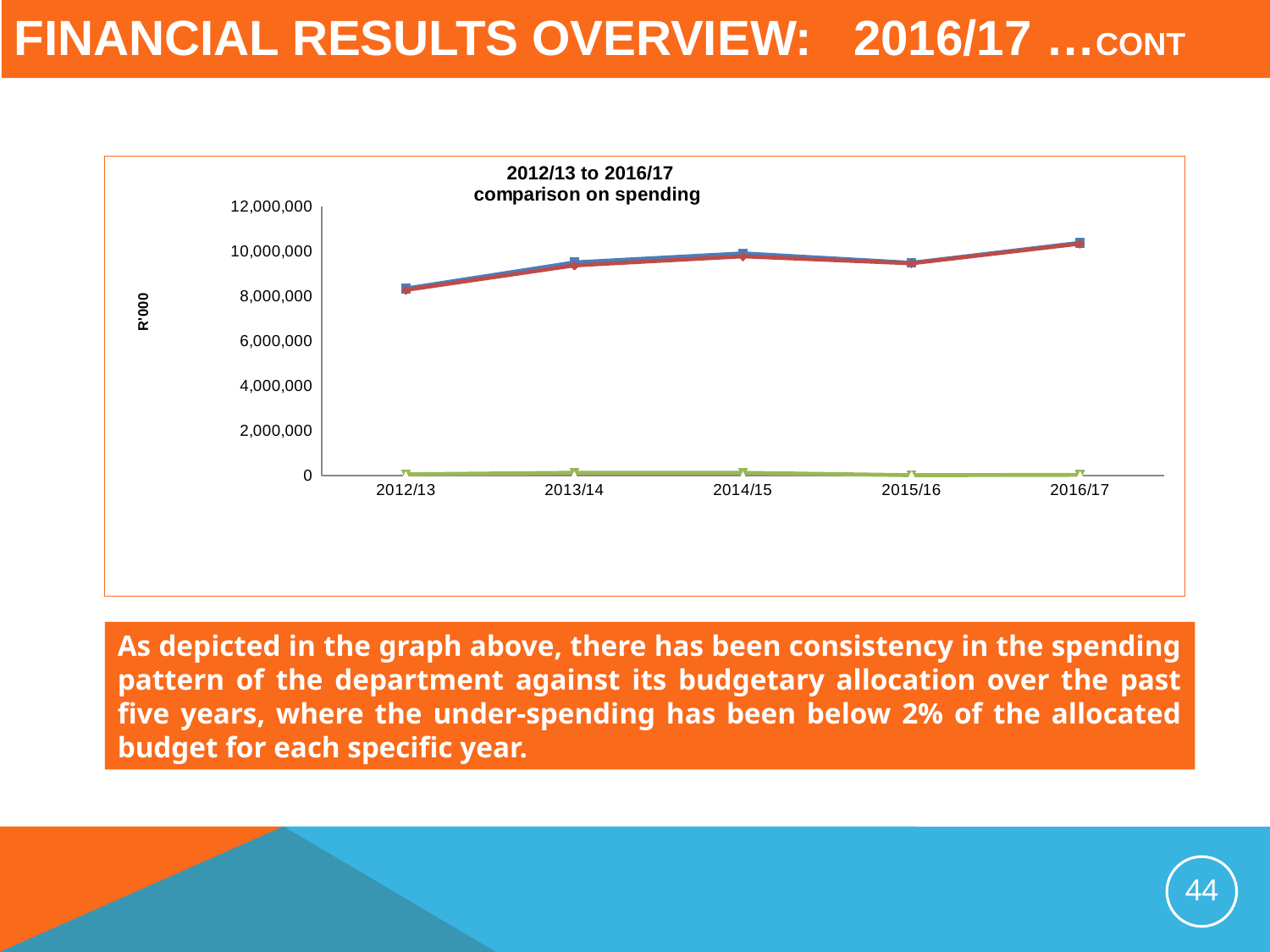
What is the label on the vertical axis of the chart? R'000 Which financial year is the last point on the x axis? 2016/17 Which financial year is the first point on the x axis? 2012/13 How many financial years are plotted along the x axis? 5 Is the value of the blue line for 2012/13 greater or less than 10,000,000? less Is the value of the blue line for 2016/17 greater or less than 10,000,000? greater Is the value of the green line for 2014/15 greater or less than 2,000,000? less Does the blue line rise or fall from 2012/13 to 2014/15? rise In which financial year does the blue line reach its highest value? 2016/17 In which financial year does the blue line reach its lowest value? 2012/13 What kind of chart is shown on the slide? line chart What is the title of the chart? 2012/13 to 2016/17 comparison on spending